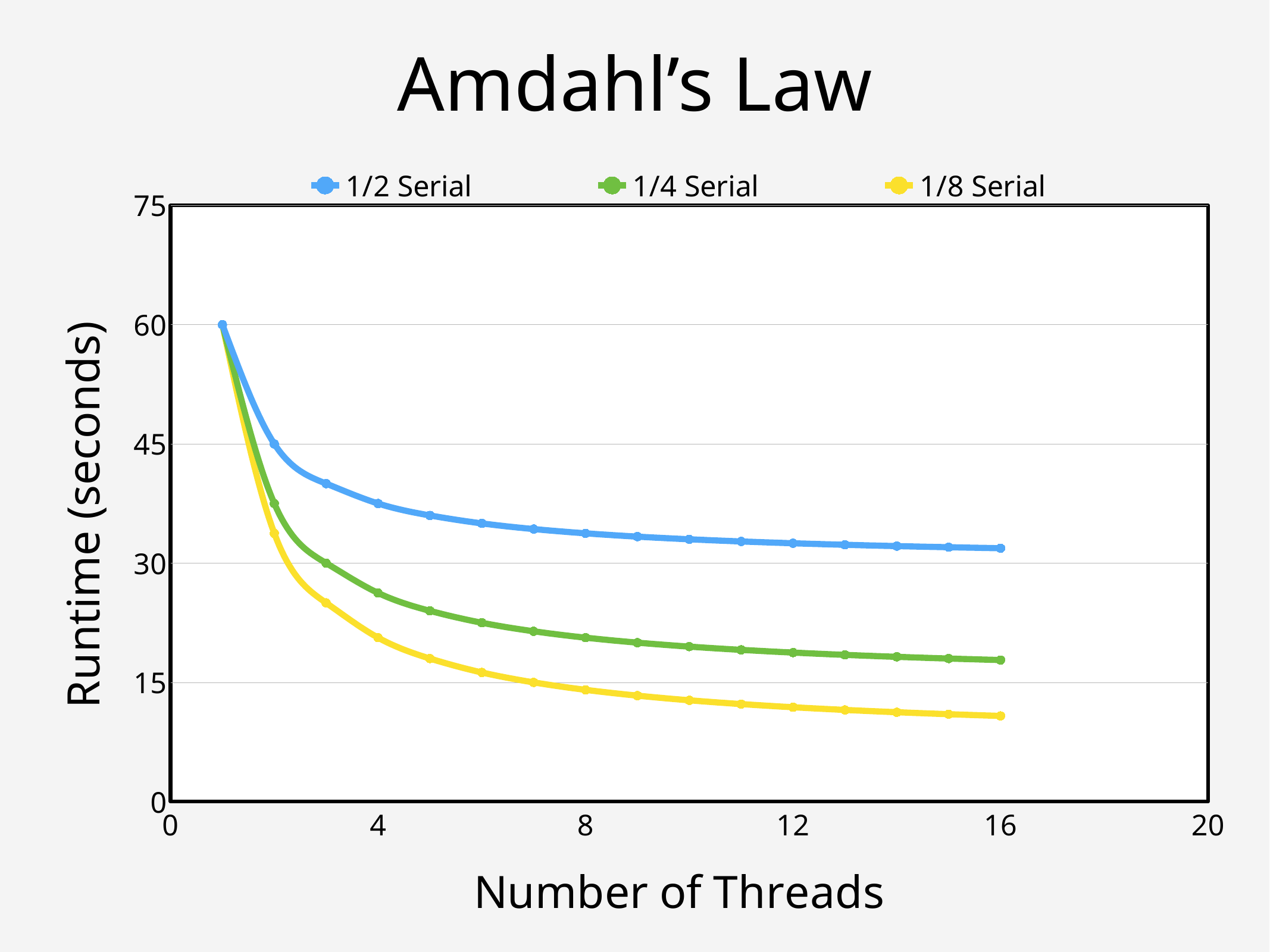
Is the runtime for 1/2 Serial at 16 threads greater or less than 30? greater Which series has the lowest runtime at 16 threads? 1/8 Serial What is the runtime for 1/2 Serial at 1 thread? 60 How many series does the legend list? 3 What kind of chart is shown on the slide? Line chart What is the title of the chart? Amdahl's Law What is the runtime for 1/8 Serial at 7 threads? 15 What is the runtime for 1/2 Serial at 2 threads? 45 Do the runtime values rise or fall as the number of threads increases? Fall Is the runtime for 1/8 Serial at 16 threads greater or less than 15? less Which series has the highest runtime at 16 threads? 1/2 Serial What is the runtime for 1/4 Serial at 3 threads? 30